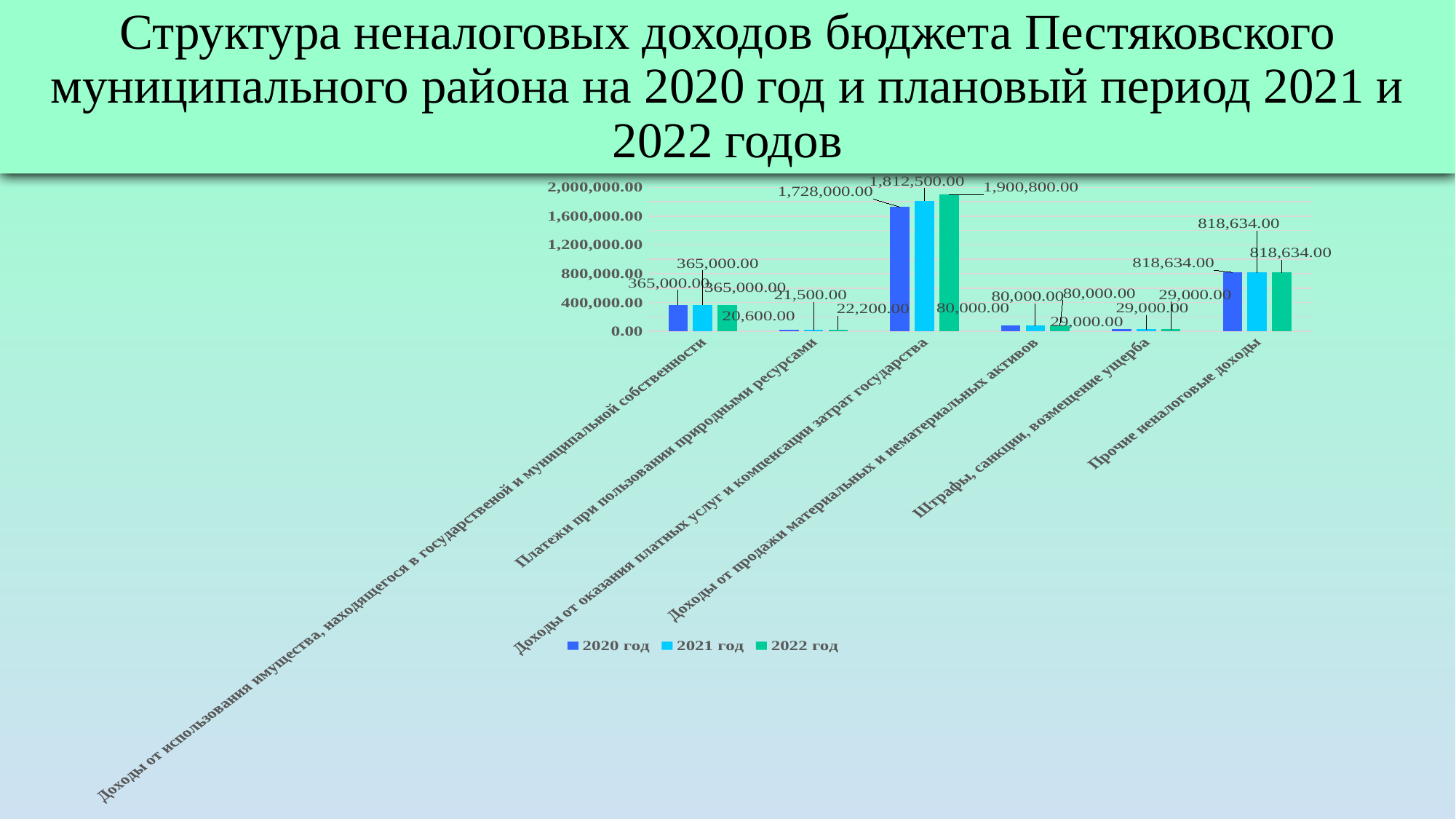
What is the value for 2020 год in the category 'Доходы от оказания платных услуг и компенсации затрат государства'? 1,728,000.00 How many categories are shown on the x axis? 6 Which category has the lowest value for 2020 год? Платежи при пользовании природными ресурсами Which series is shown in the darkest blue colour in the legend? 2020 год What is the difference between the 2022 год and 2020 год values for 'Доходы от оказания платных услуг и компенсации затрат государства'? 172,800.00 What is the value for 2021 год in the category 'Платежи при пользовании природными ресурсами'? 21,500.00 How many series does the legend list? 3 What kind of chart is shown on the slide? Bar chart Which category has the highest value for 2022 год? Доходы от оказания платных услуг и компенсации затрат государства What is the value for 2022 год in the category 'Прочие неналоговые доходы'? 818,634.00 What is the value for 2022 год in the category 'Доходы от оказания платных услуг и компенсации затрат государства'? 1,900,800.00 Which is larger: the 2021 год value for 'Прочие неналоговые доходы' or the 2021 год value for 'Доходы от продажи материальных и нематериальных активов'? Прочие неналоговые доходы